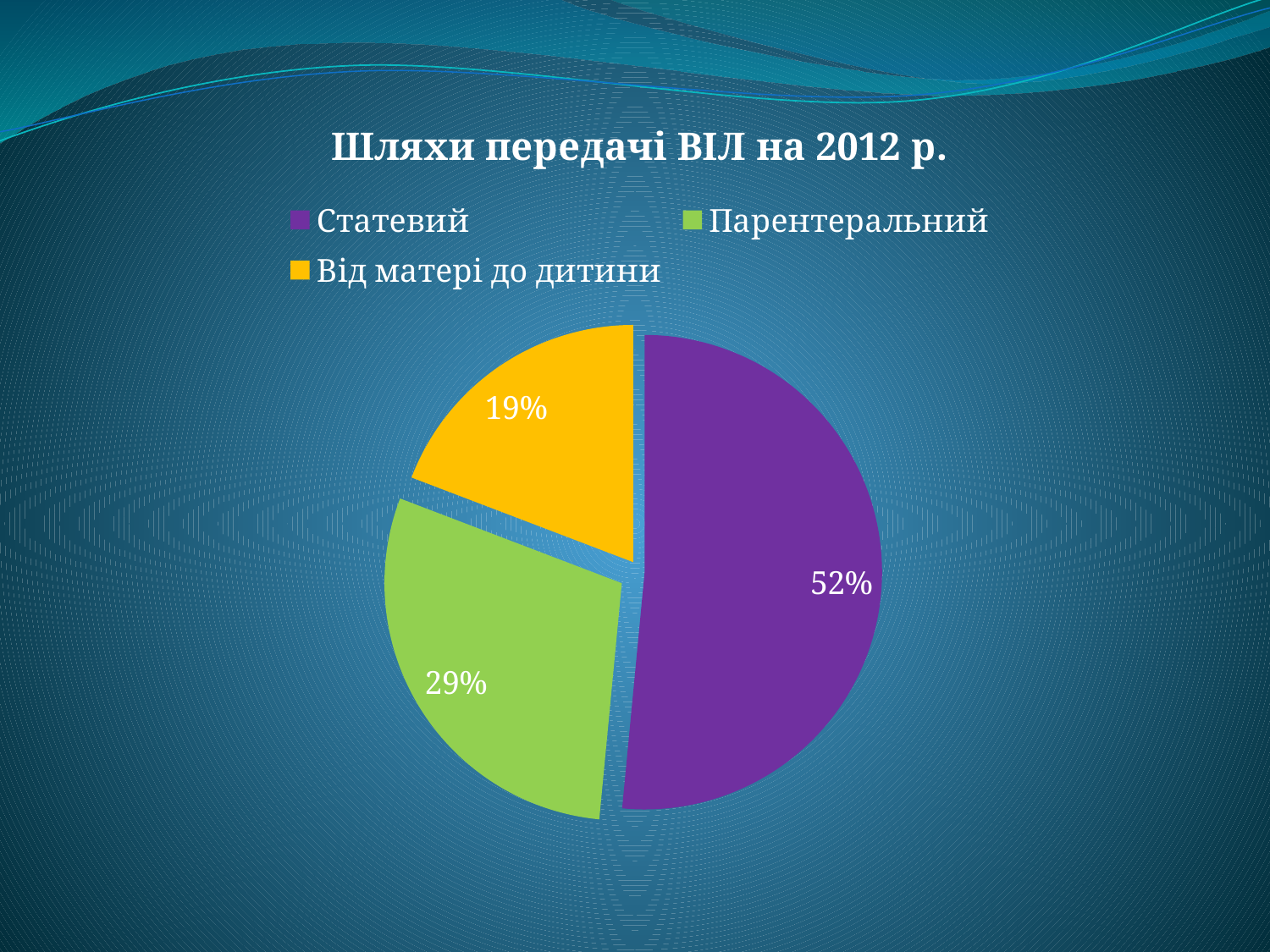
What kind of chart is shown on the slide? pie chart What is the difference in percentage points between Статевий and Парентеральний? 23 What is the title of the chart? Шляхи передачі ВІЛ на 2012 р. Which transmission route has the largest slice? Статевий How many entries does the legend list? 3 What share of the pie is labelled for Парентеральний? 29% What share of the pie is labelled for Від матері до дитини? 19% What colour is the slice for Від матері до дитини? yellow Which is larger, the slice for Парентеральний or the slice for Від матері до дитини? Парентеральний What share of the pie is labelled for Статевий? 52% How many slices does the pie chart have? 3 Which transmission route has the smallest slice? Від матері до дитини